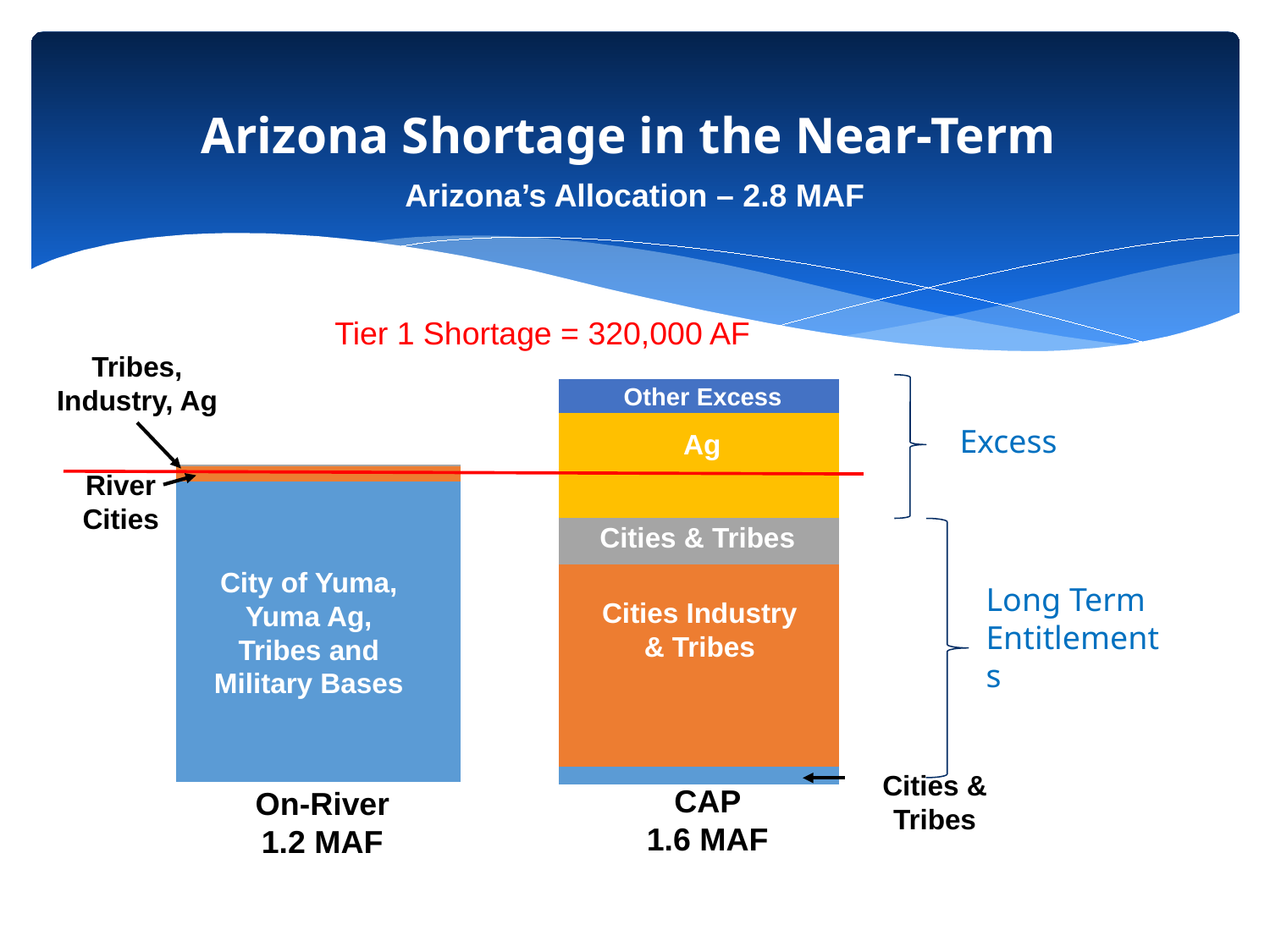
Which segment of the CAP bar is the largest? Cities Industry & Tribes What is the total value of the CAP bar? 1.6 MAF What is Arizona's total allocation shown on the slide? 2.8 MAF Which segments of the CAP bar are grouped under the 'Excess' bracket? Other Excess and Ag What kind of chart is shown on the slide? Stacked bar chart What is the label of the topmost segment of the CAP bar? Other Excess Which segment of the On-River bar is the largest? City of Yuma, Yuma Ag, Tribes and Military Bases What is the total value of the On-River bar? 1.2 MAF How many bars does the chart show? 2 Which bar is larger, On-River or CAP? CAP What is the difference between the CAP total and the On-River total? 0.4 MAF What is the Tier 1 Shortage value shown on the chart? 320,000 AF